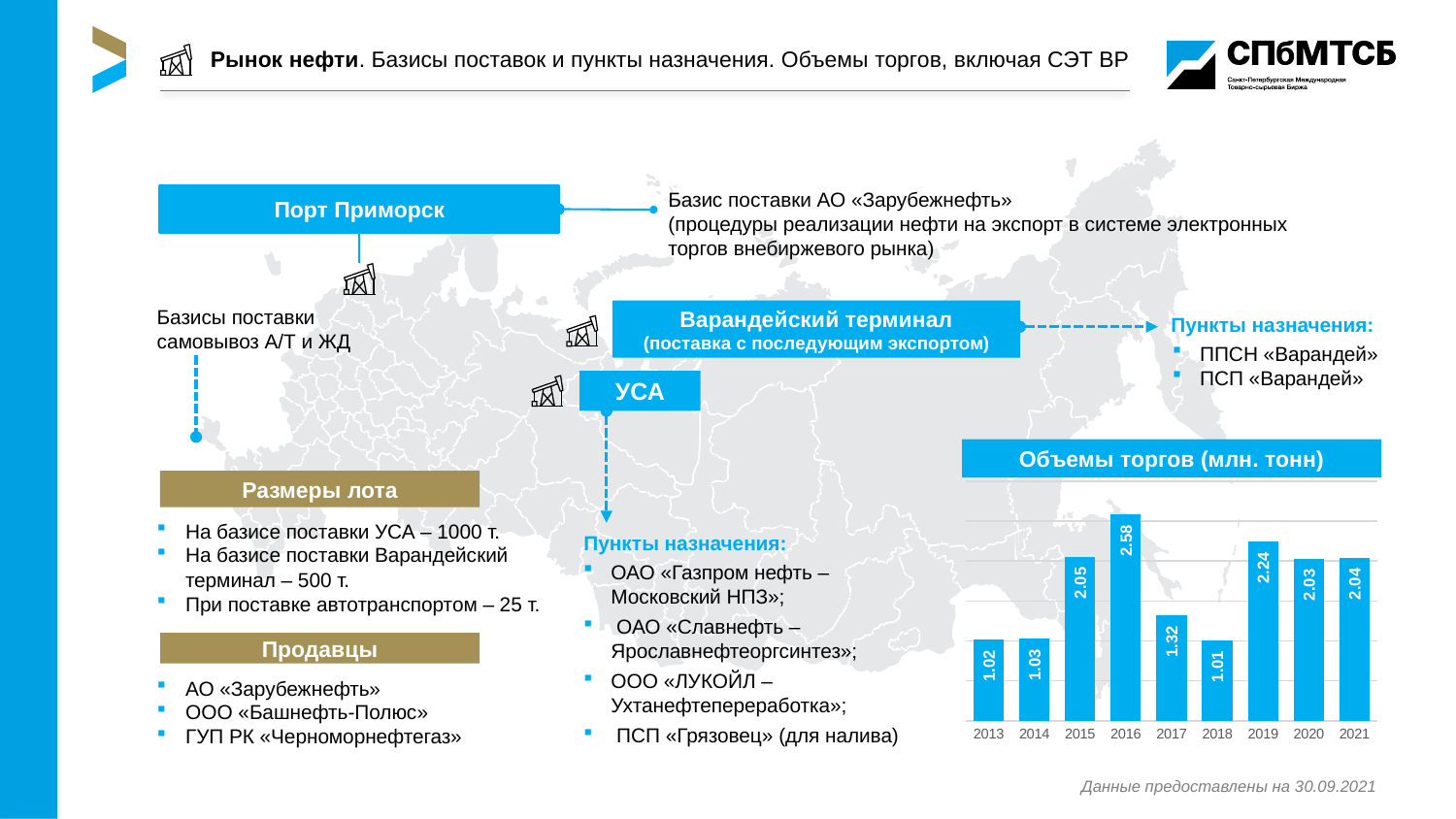
What is the trading volume shown for 2013 in the chart "Объемы торгов (млн. тонн)"? 1.02 What is the trading volume shown for 2016 in the chart "Объемы торгов (млн. тонн)"? 2.58 In the chart "Объемы торгов (млн. тонн)", what is the difference between the values for 2019 and 2020? 0.21 Which year has the highest trading volume in the chart "Объемы торгов (млн. тонн)"? 2016 In the chart "Объемы торгов (млн. тонн)", which year has the larger value, 2019 or 2021? 2019 Which year has the lowest trading volume in the chart "Объемы торгов (млн. тонн)"? 2018 What is the title of the chart on the slide? Объемы торгов (млн. тонн) How many years are shown on the x axis of the chart "Объемы торгов (млн. тонн)"? 9 What is the trading volume shown for 2019 in the chart "Объемы торгов (млн. тонн)"? 2.24 In the chart "Объемы торгов (млн. тонн)", which year has the larger value, 2015 or 2017? 2015 What kind of chart is "Объемы торгов (млн. тонн)"? Bar chart In the chart "Объемы торгов (млн. тонн)", what is the difference between the values for 2016 and 2017? 1.26